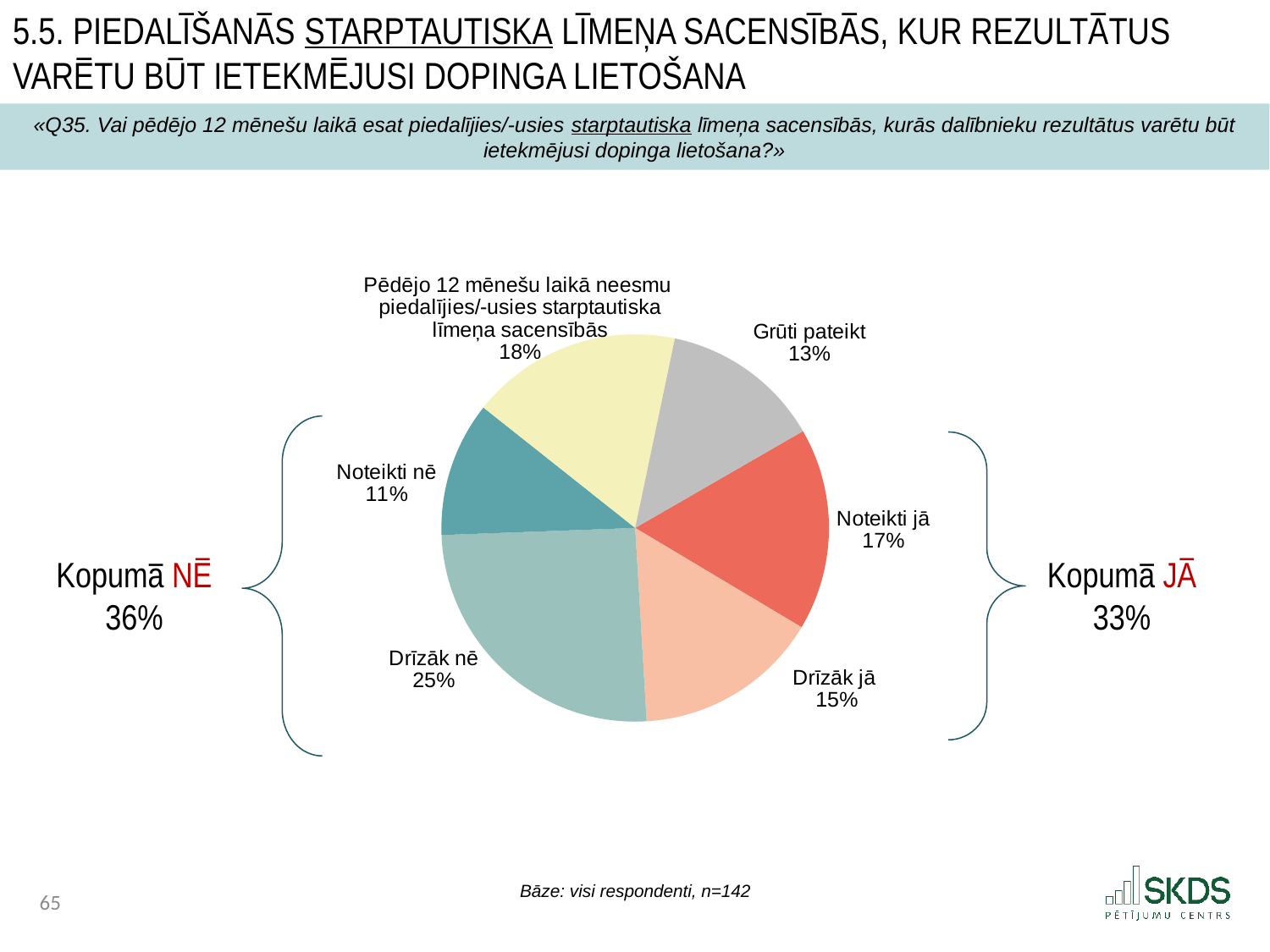
What share of the pie is labelled "Grūti pateikt"? 13% What is the combined percentage shown for "Kopumā JĀ"? 33% Which slice of the pie is the largest? Drīzāk nē What percentage of respondents said they had not participated in international-level competitions in the last 12 months ("Pēdējo 12 mēnešu laikā neesmu piedalījies/-usies starptautiska līmeņa sacensībās")? 18% What percentage is shown for "Noteikti nē"? 11% Which is larger, the share for "Noteikti jā" or the share for "Noteikti nē"? Noteikti jā Which slice of the pie is the smallest? Noteikti nē What kind of chart is shown on the slide? Pie chart What is the difference in percentage points between "Drīzāk nē" and "Drīzāk jā"? 10 What percentage of respondents answered "Drīzāk nē"? 25% What percentage of respondents answered "Noteikti jā"? 17% How many slices does the pie chart have? 6